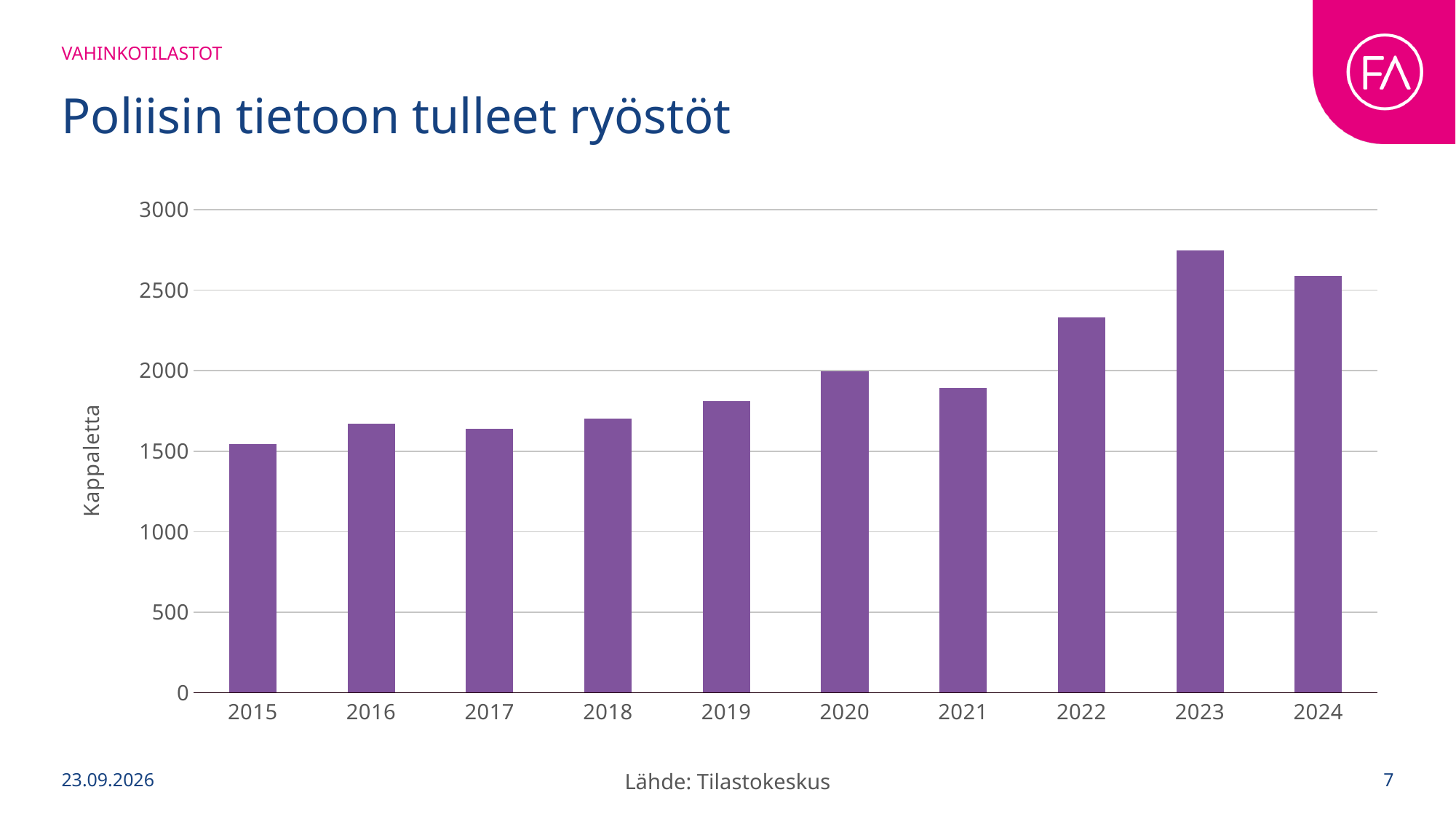
Which year has a higher value, 2023 or 2024? 2023 How many years are shown on the x axis of the chart? 10 Which year has the lowest number of robberies reported to the police? 2015 What type of chart is shown on the slide? bar chart Overall, do the values rise or fall from 2015 to 2023? rise Is the value for 2022 greater or less than 2000? greater Which year has the highest number of robberies reported to the police? 2023 What is the label on the y axis of the chart? Kappaletta Is the value for 2023 greater or less than 2500? greater Which year has a higher value, 2020 or 2021? 2020 Is the value for 2015 greater or less than 2000? less